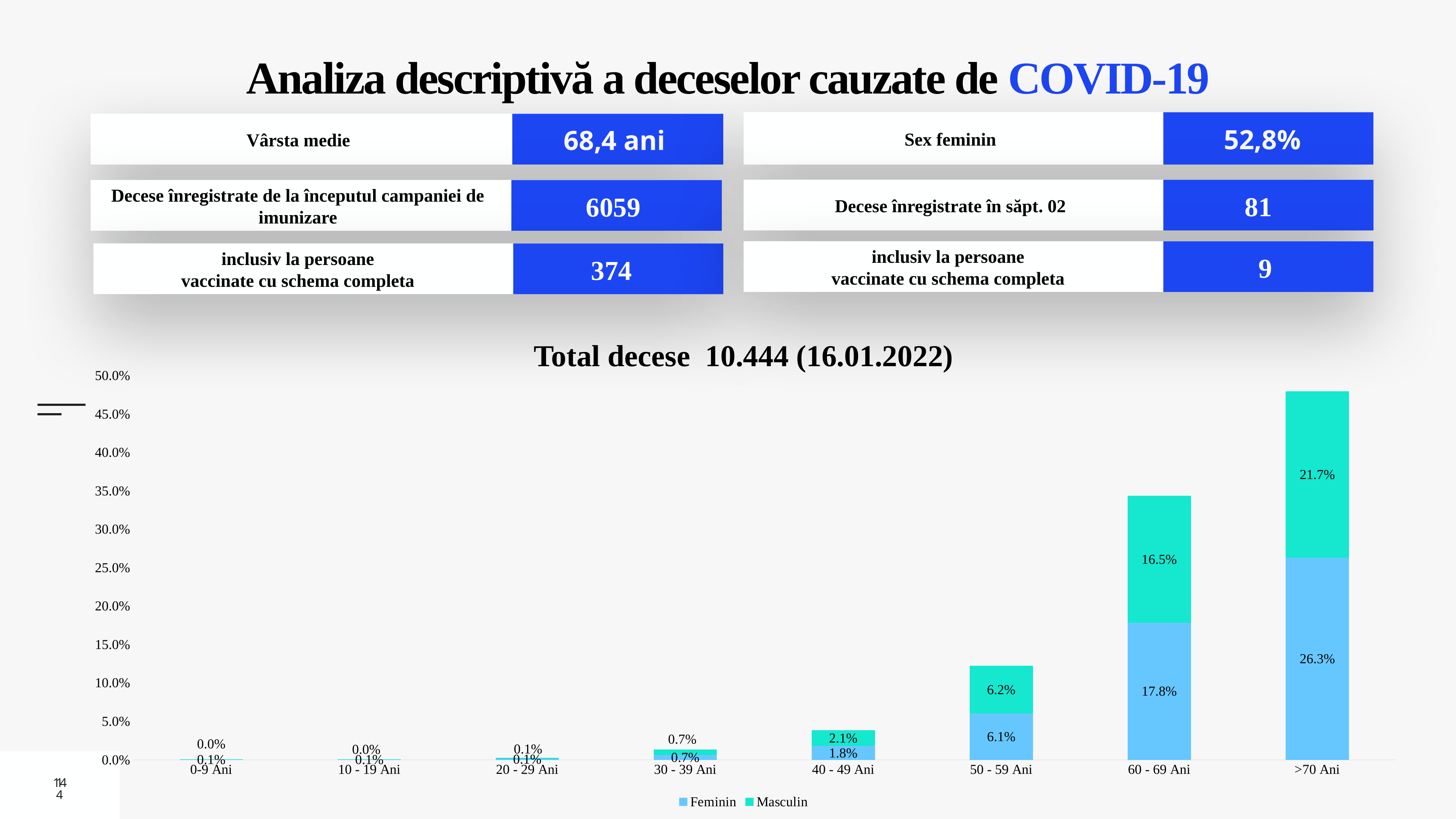
What is the title shown above the chart? Total decese 10.444 (16.01.2022) What is the Feminin value for the 50 - 59 Ani age group? 6.1% What is the total of the stacked bar for the 60 - 69 Ani age group? 34.3% What is the Masculin value for the 60 - 69 Ani age group? 16.5% How many age groups are shown on the x axis of the chart? 8 What is the difference between the Feminin and Masculin values for the >70 Ani age group? 4.6% Which age group has the highest total stacked bar? >70 Ani What is the Masculin value for the 40 - 49 Ani age group? 2.1% What type of chart is shown on the slide? stacked bar chart What is the Feminin value for the >70 Ani age group? 26.3% For the 60 - 69 Ani age group, which is larger, the Feminin or the Masculin value? Feminin How many series does the chart legend list? 2